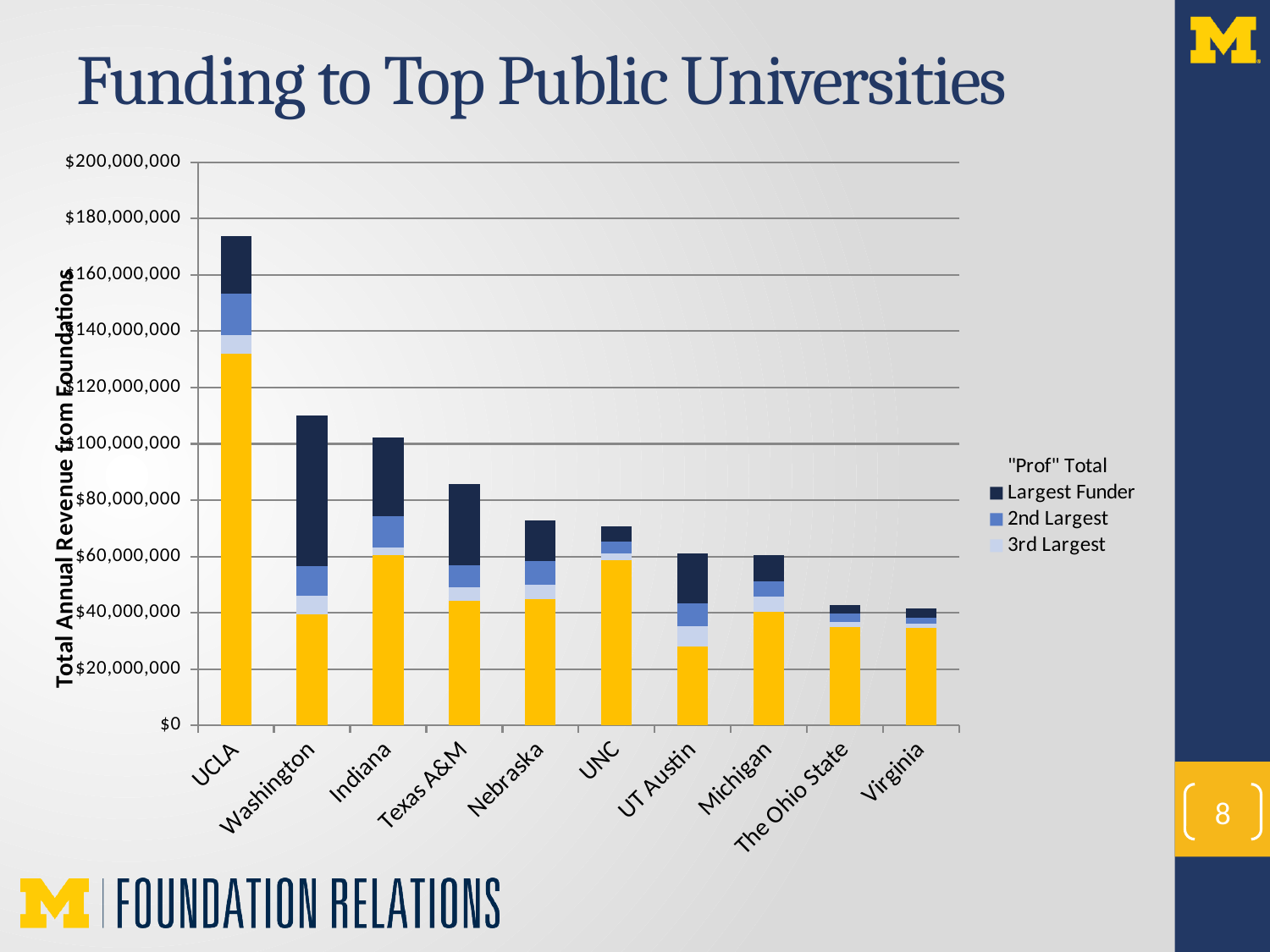
Which university has the highest total bar in the chart? UCLA Do the total bar heights generally rise or fall moving from left to right along the x axis? fall How many series does the chart's legend list? 4 Is the total bar for Texas A&M greater or less than $80,000,000? greater How many universities are shown on the x axis of the chart? 10 Is the total bar for UCLA greater or less than $160,000,000? greater Is the total bar for UNC greater or less than $80,000,000? less What is the title of the chart's vertical axis? Total Annual Revenue from Foundations What kind of chart is shown on the slide? Stacked bar chart Which has the larger total bar, Texas A&M or Nebraska? Texas A&M